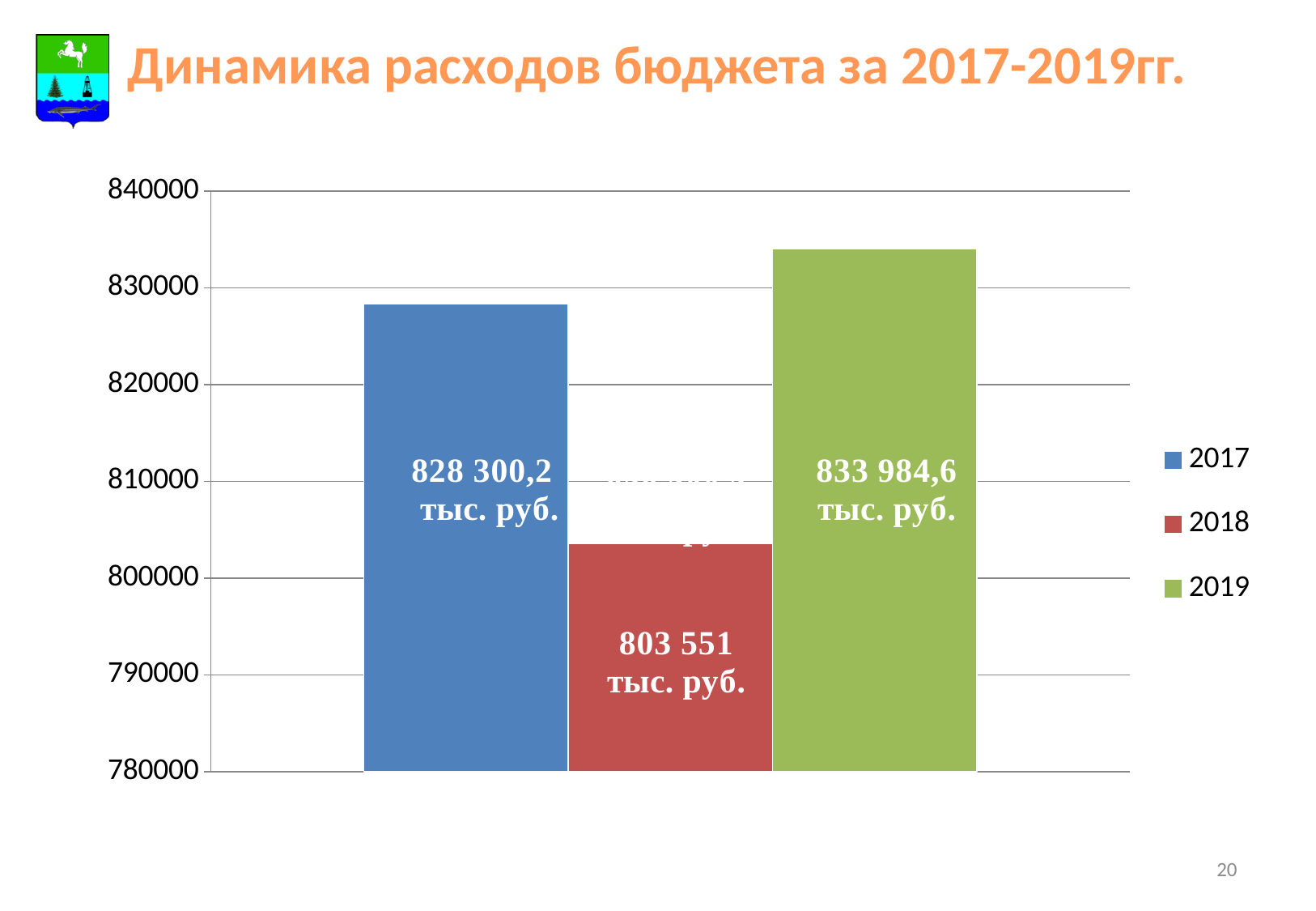
What is the difference between the values for 2019 and 2017? 5 684,4 тыс. руб. What is the value shown for 2019? 833 984,6 тыс. руб. Is the value for 2018 greater or less than 810000? less Which year has the highest budget expenditure? 2019 What is the difference between the values for 2017 and 2018? 24 749,2 тыс. руб. How many entries does the legend list? 3 What is the value shown for 2018? 803 551 тыс. руб. Which year has the lowest budget expenditure? 2018 How many bars are plotted on the chart? 3 What is the value shown for 2017? 828 300,2 тыс. руб. What kind of chart is shown on the slide? bar chart Which is larger, the value for 2017 or the value for 2018? 2017